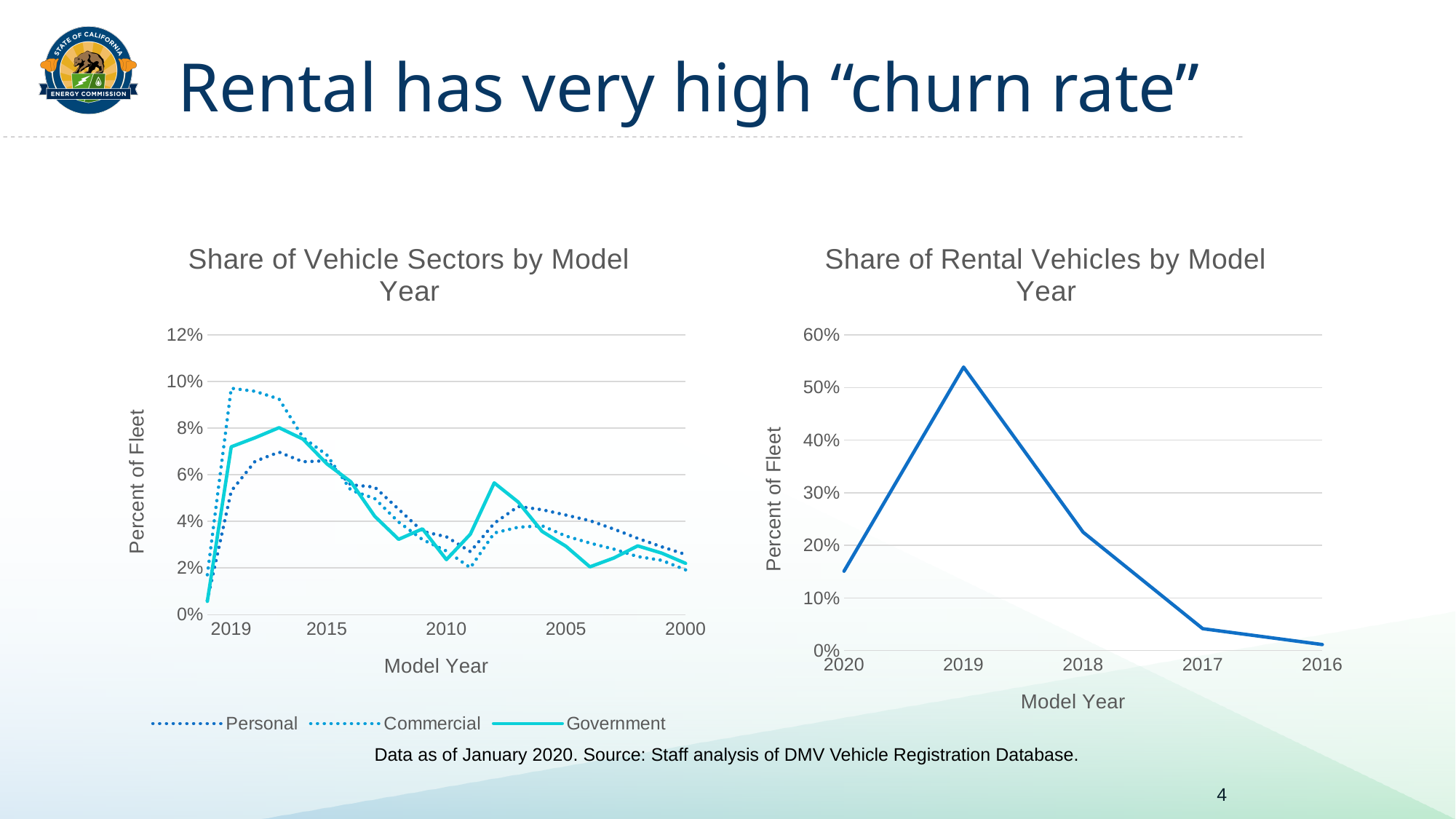
What is the y-axis label of the 'Share of Vehicle Sectors by Model Year' chart? Percent of Fleet In the 'Share of Vehicle Sectors by Model Year' chart, which series has the highest value at model year 2019? Commercial In the 'Share of Rental Vehicles by Model Year' chart, which model year has the highest share? 2019 In the 'Share of Rental Vehicles by Model Year' chart, is the value for 2020 greater or less than 20%? less In the 'Share of Rental Vehicles by Model Year' chart, is the value for 2019 greater or less than 50%? greater How many series does the legend of the 'Share of Vehicle Sectors by Model Year' chart list? 3 In the 'Share of Rental Vehicles by Model Year' chart, is the value for 2017 greater or less than 10%? less What kind of chart is the 'Share of Rental Vehicles by Model Year' chart? line chart In the 'Share of Rental Vehicles by Model Year' chart, do the values rise or fall from 2019 to 2016? fall What are the legend entries of the 'Share of Vehicle Sectors by Model Year' chart? Personal, Commercial, Government In the 'Share of Rental Vehicles by Model Year' chart, which model year has the lowest share? 2016 In the 'Share of Rental Vehicles by Model Year' chart, how many model years are plotted on the x axis? 5